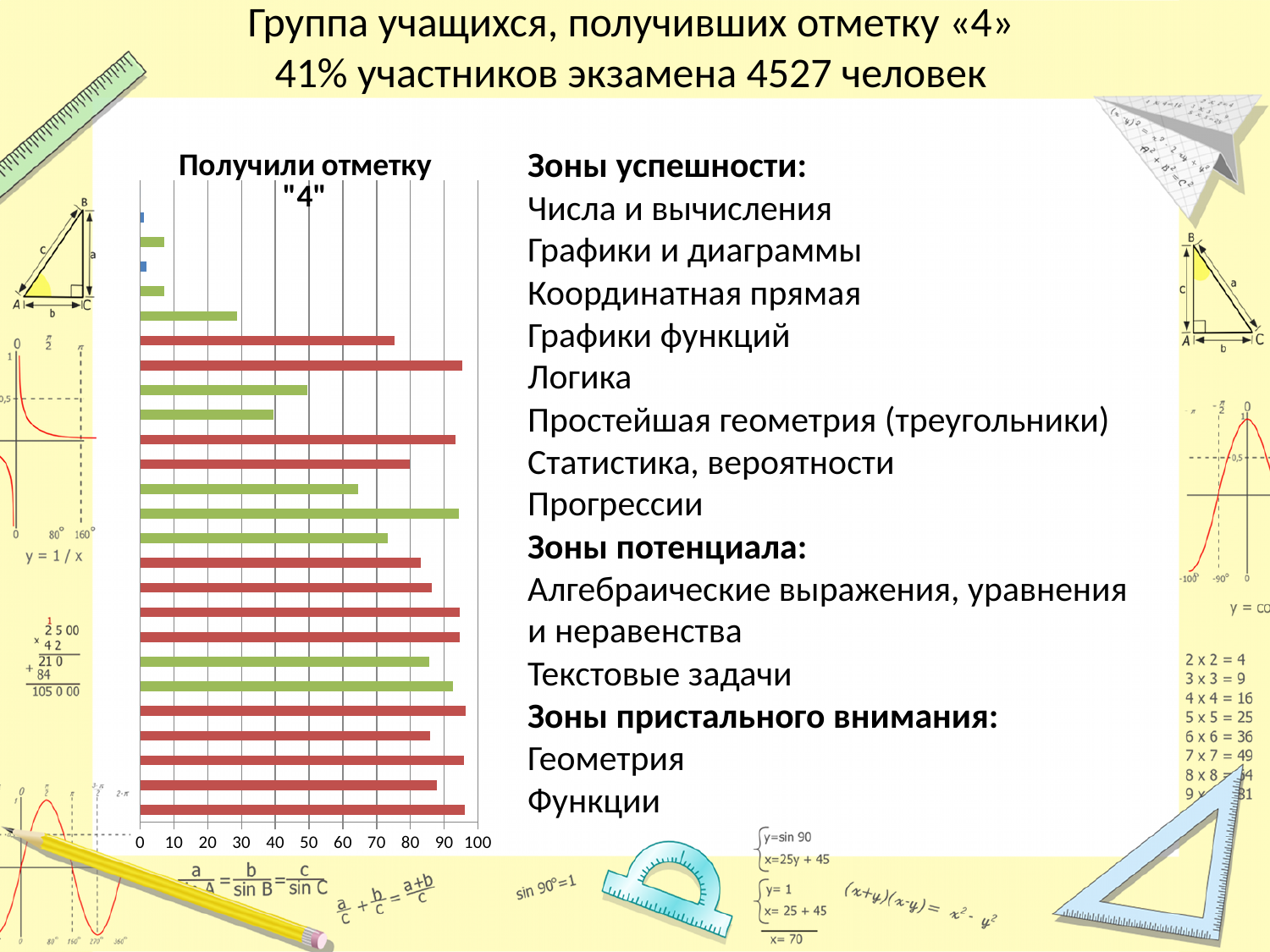
What is the highest value shown on the chart's horizontal axis? 100 Is the value of the ninth bar from the top greater or less than 50? less Is the value of the bottom bar on the chart greater or less than 90? greater Is the value of the topmost bar on the chart greater or less than 10? less Which is larger: the value of the fifth bar from the top or the value of the sixth bar from the top? the sixth bar from the top What is the title of the chart? Получили отметку "4" What kind of chart is shown on the slide? bar chart Which is larger: the value of the topmost bar or the value of the bottom bar? the bottom bar How many bars are plotted on the chart? 25